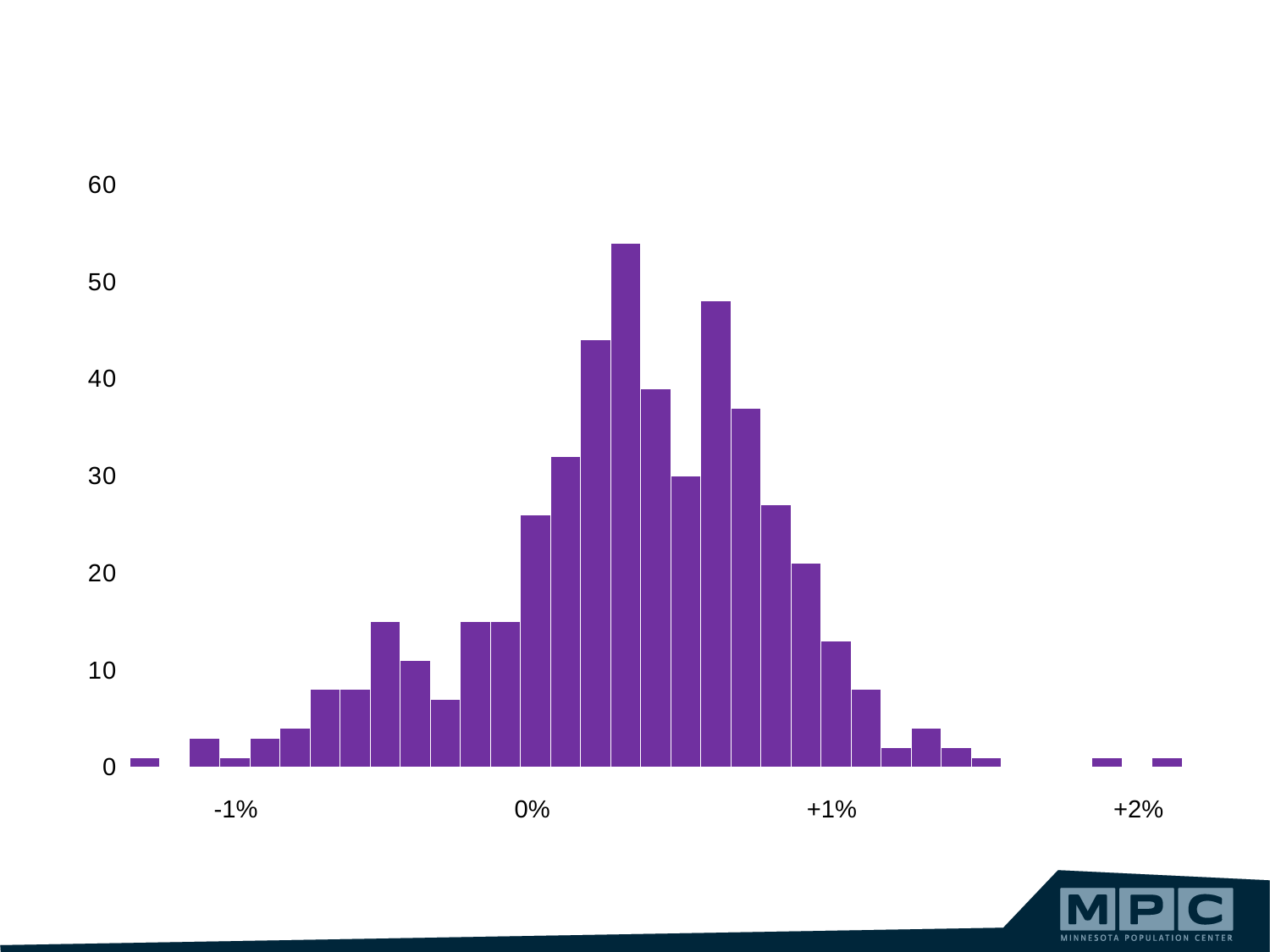
Is the value of the tallest bar greater or less than 60? less Are the bars near the -1% label greater or less than 10? less Between which two x-axis labels does the tallest bar fall? 0% and +1% Is the second-tallest bar greater or less than 40? greater What is the highest value shown on the y axis? 60 What kind of chart is shown on the slide? bar chart Do the bar heights generally rise or fall moving from the +1% label toward the +2% label? fall Do the bar heights generally rise or fall moving from the -1% label toward the 0% label? rise What colour are the bars in the chart? purple